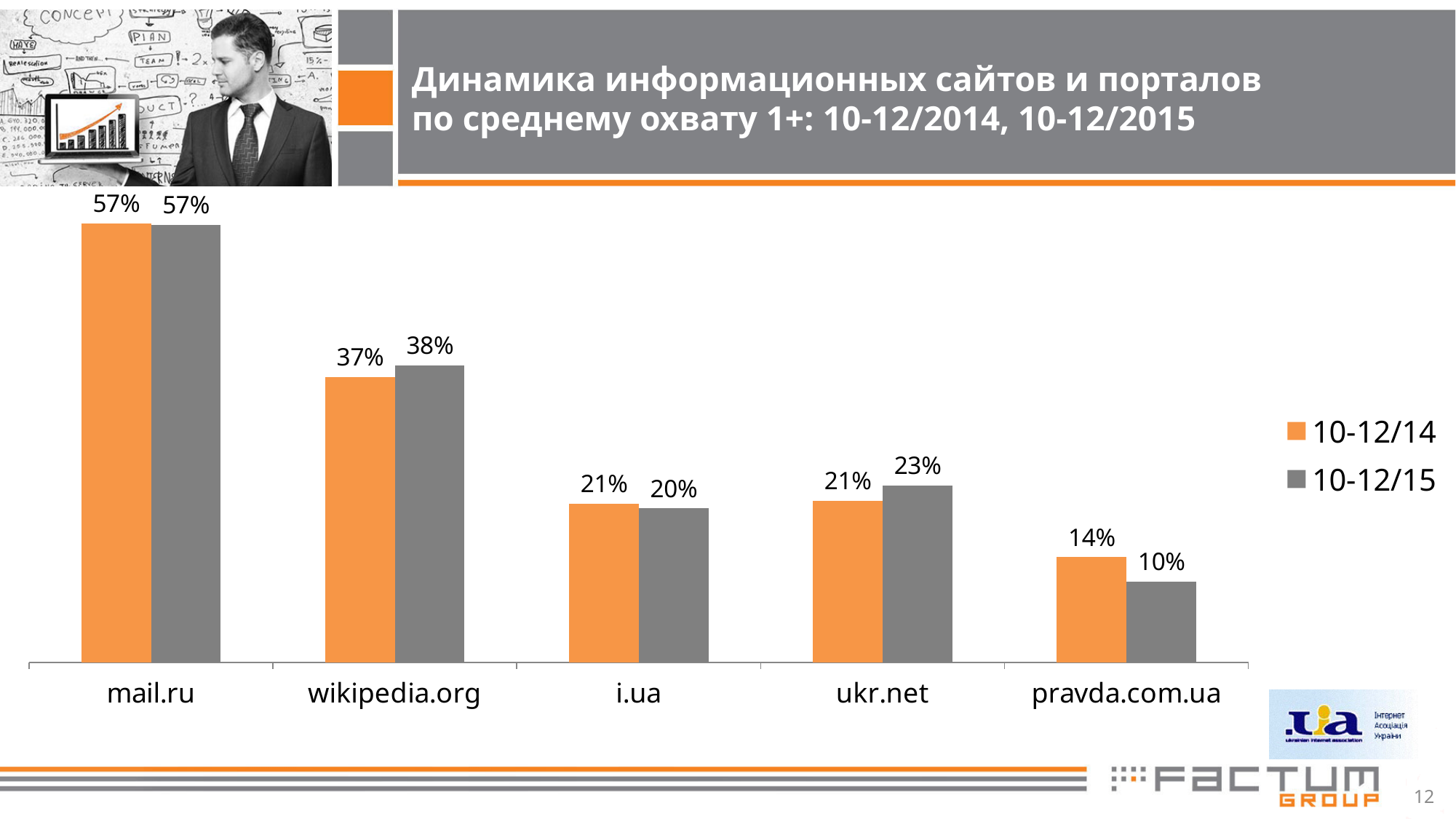
Which is larger for ukr.net: the 10-12/14 value or the 10-12/15 value? 10-12/15 How many sites are shown on the x axis? 5 What is the value for pravda.com.ua in the 10-12/15 series? 10% What is the value for wikipedia.org in the 10-12/15 series? 38% How many series does the legend list? 2 What is the difference between the 10-12/14 and 10-12/15 values for pravda.com.ua? 4% What kind of chart is shown on the slide? bar chart Which site has the lowest value in the 10-12/14 series? pravda.com.ua Which site has the highest value in the 10-12/15 series? mail.ru What is the value for mail.ru in the 10-12/14 series? 57% What is the value for ukr.net in the 10-12/14 series? 21% Which colour represents the 10-12/14 series in the legend? orange